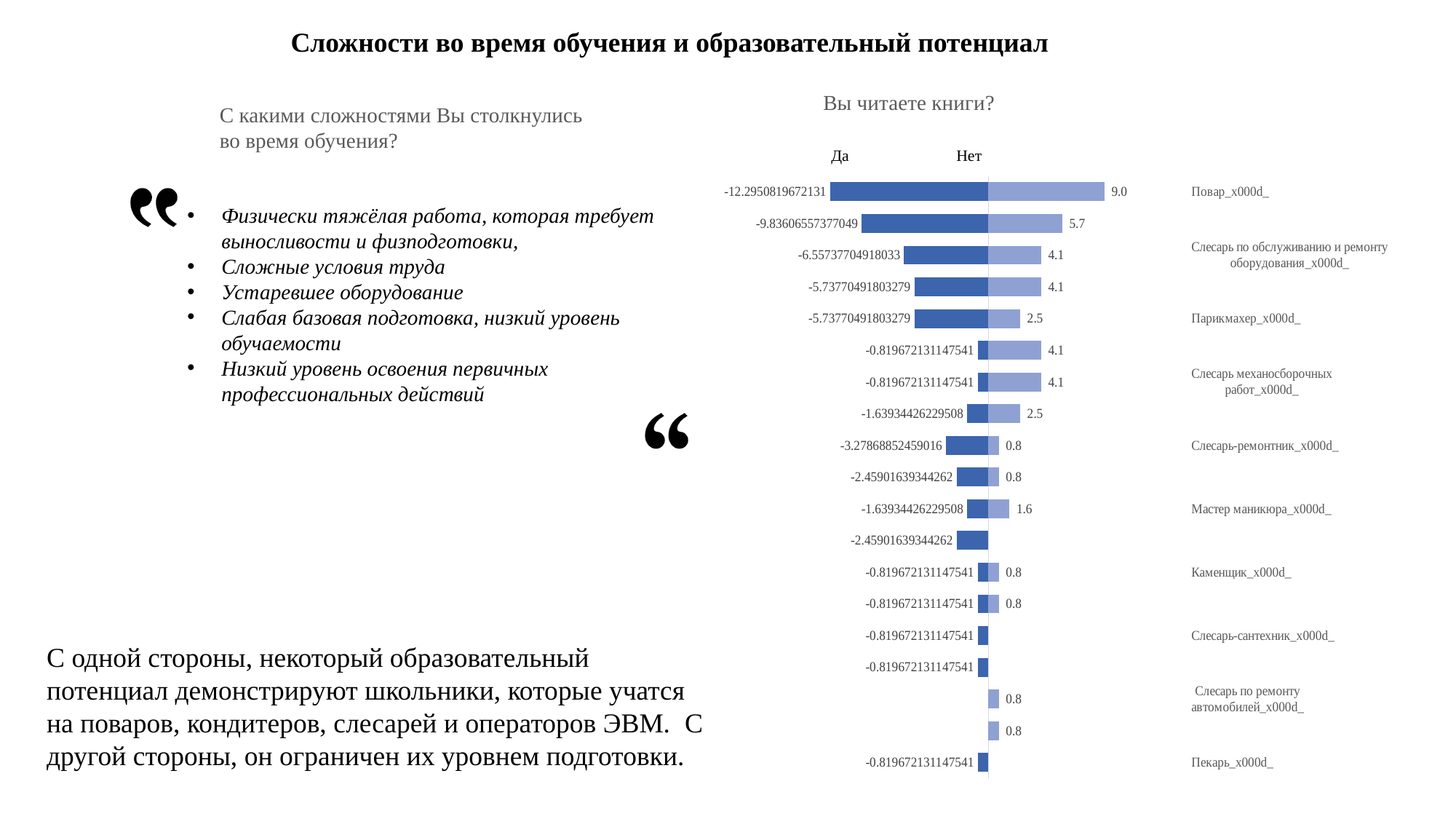
How many bar rows are plotted in the chart "Вы читаете книги?"? 19 In the chart "Вы читаете книги?", what is the "Да" value for Слесарь-ремонтник? -3.27868852459016 In the chart "Вы читаете книги?", what is the "Нет" value for Парикмахер? 2.5 In the chart "Вы читаете книги?", what is the "Нет" value for Повар? 9.0 What are the two series names shown above the chart "Вы читаете книги?"? Да and Нет In the chart "Вы читаете книги?", what is the difference between the "Нет" values for Повар and Парикмахер? 6.5 In the chart "Вы читаете книги?", which labelled category has the highest "Нет" value? Повар In the chart "Вы читаете книги?", what is the "Да" value for Повар? -12.2950819672131 How many series does the chart "Вы читаете книги?" show? 2 In the chart "Вы читаете книги?", which has the larger "Нет" value: Повар or Каменщик? Повар What kind of chart is shown under the title "Вы читаете книги?"? bar chart In the chart "Вы читаете книги?", what is the "Нет" value for Мастер маникюра? 1.6